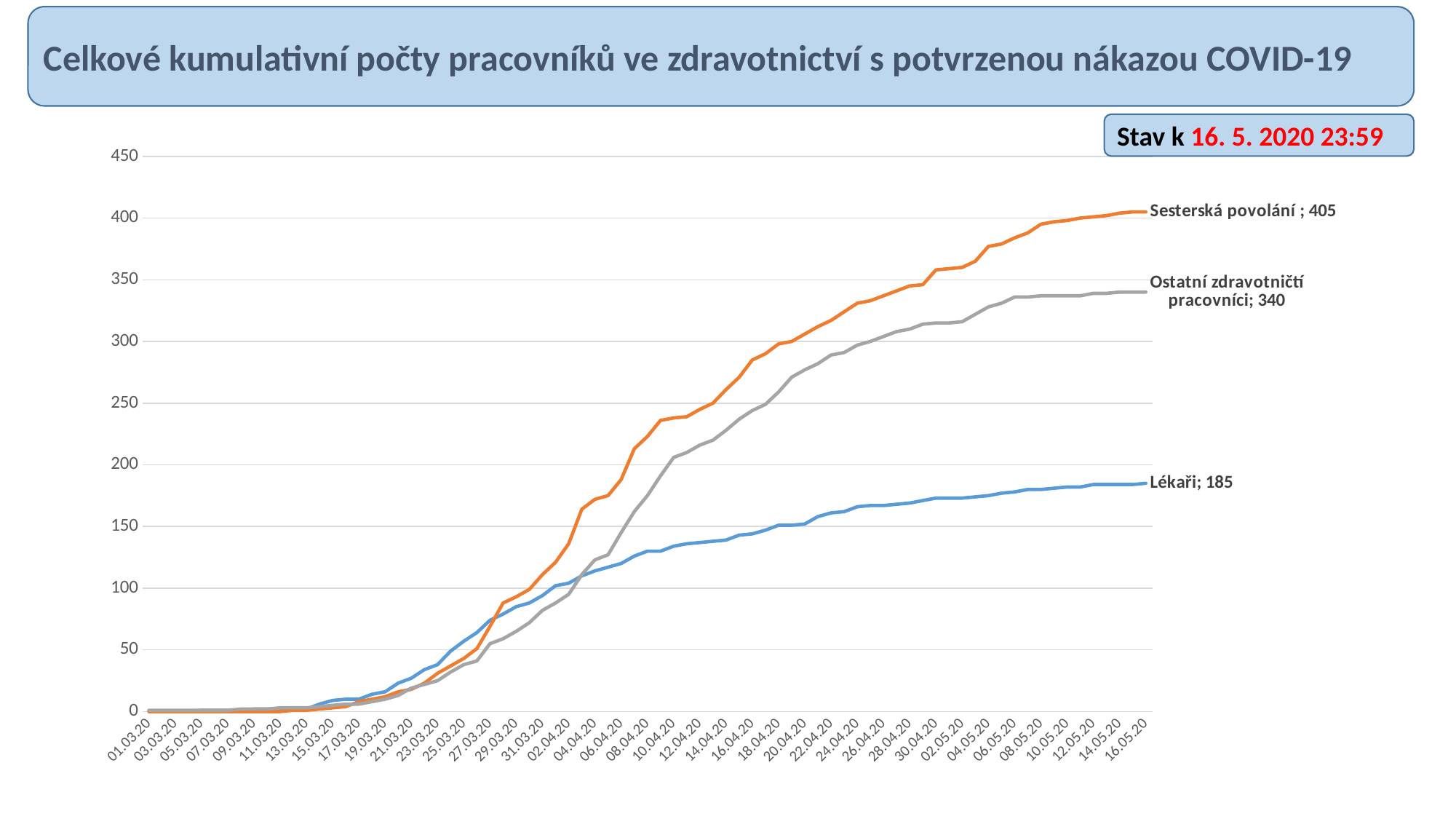
How many series are plotted on the chart? 3 Is the value for Lékaři on 10.04.20 greater or less than 150? less What kind of chart is shown on the slide? line chart What is the final value shown for Lékaři? 185 Which series has the highest final value? Sesterská povolání Which series has the lowest final value? Lékaři What is the final value shown for Ostatní zdravotničtí pracovníci? 340 What is the difference between the final values of Sesterská povolání and Lékaři? 220 What is the final value shown for Sesterská povolání? 405 Do the values for Sesterská povolání rise or fall along the x axis? rise Which has a larger final value, Ostatní zdravotničtí pracovníci or Lékaři? Ostatní zdravotničtí pracovníci What is the difference between the final values of Sesterská povolání and Ostatní zdravotničtí pracovníci? 65